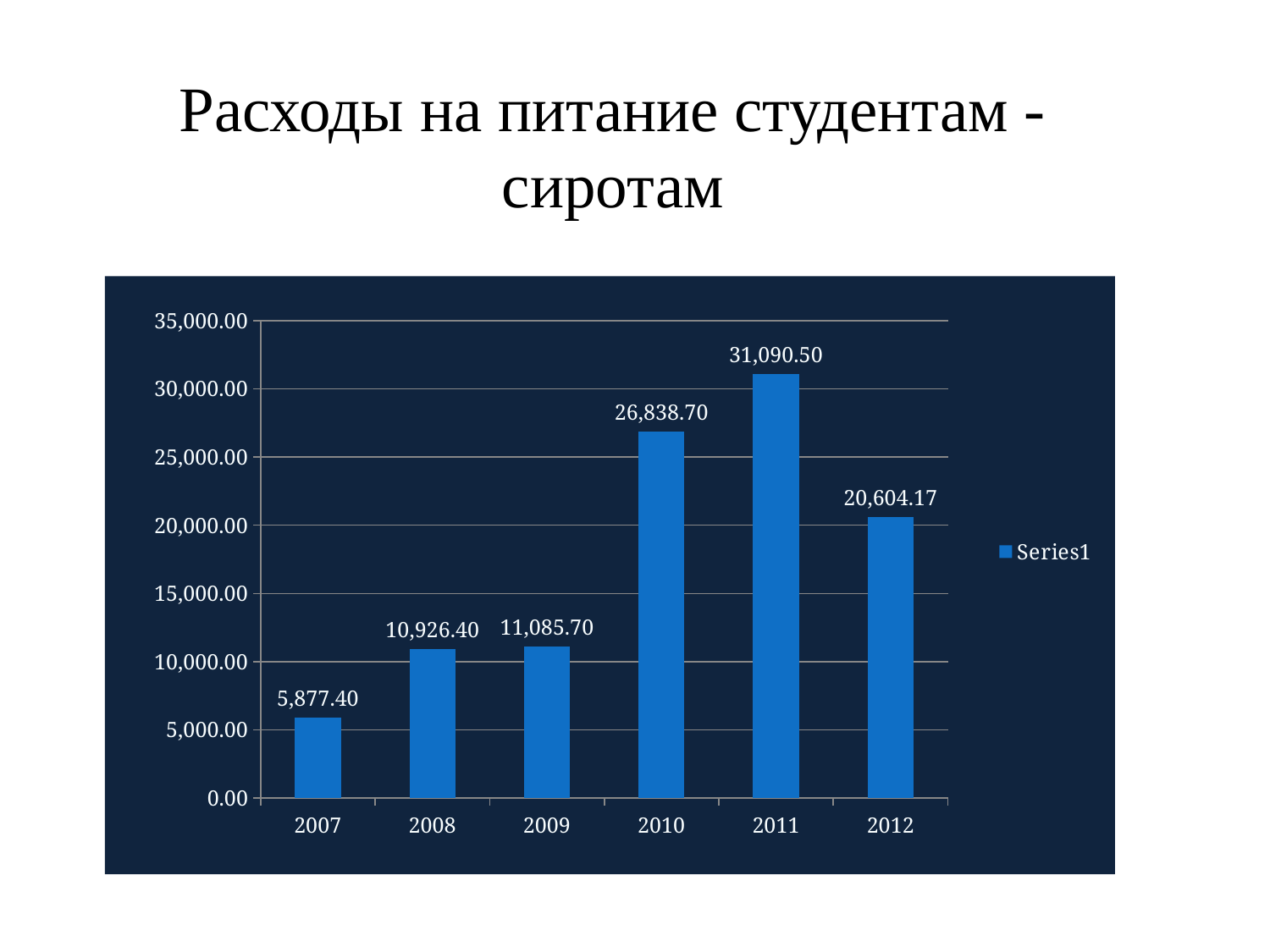
What is the value for 2012? 20,604.17 What is the difference between the values for 2011 and 2010? 4,251.80 What is the value for 2010? 26,838.70 Which year has the lowest value? 2007 What is the value for 2007? 5,877.40 What is the difference between the values for 2012 and 2007? 14,726.77 How many years are shown on the x axis? 6 What is the title of the slide? Расходы на питание студентам - сиротам Which is larger, the value for 2010 or the value for 2012? 2010 Is the value for 2009 greater or less than 15,000.00? less Which year has the highest value? 2011 What kind of chart is shown on the slide? bar chart